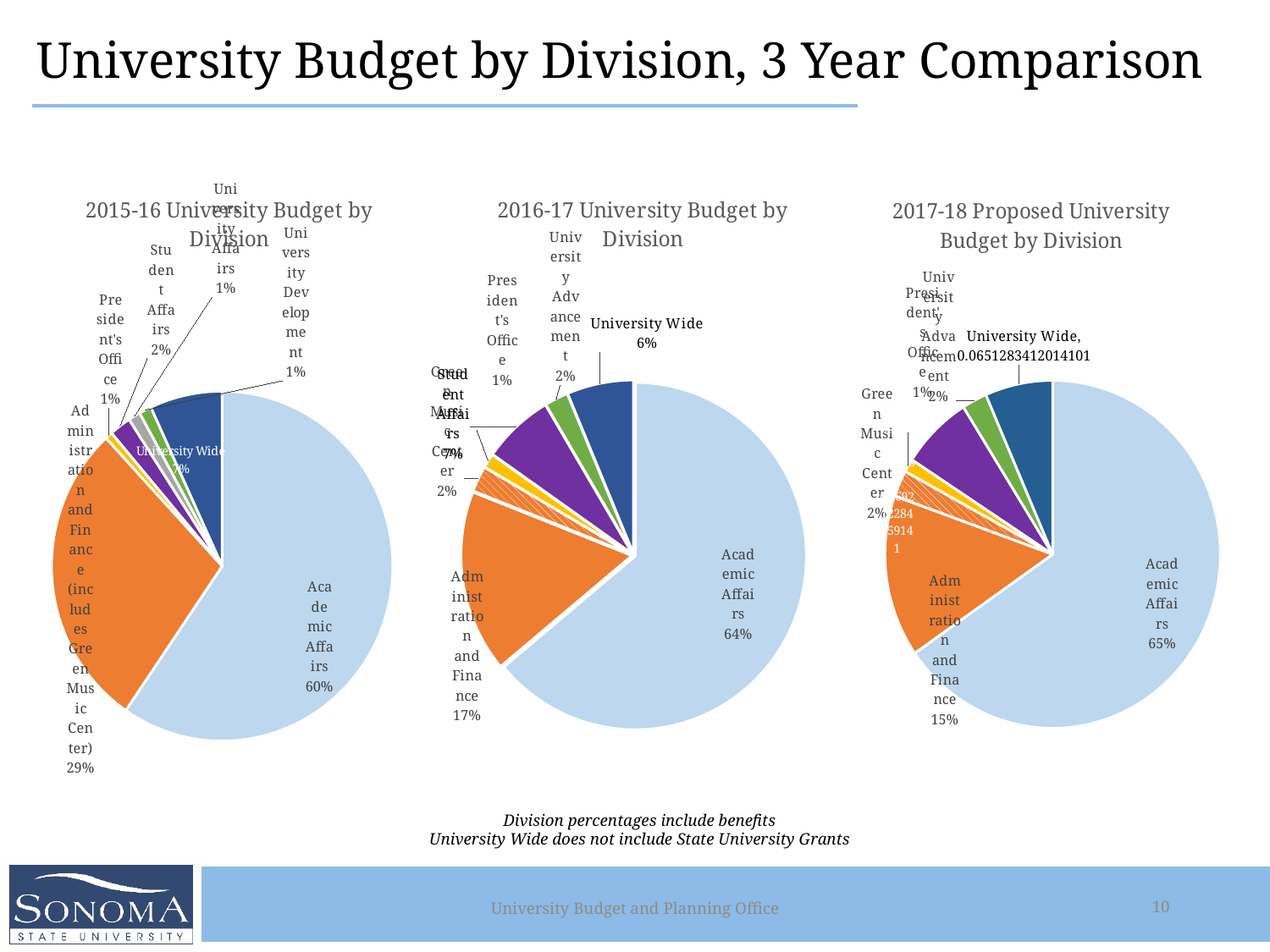
In the 2016-17 University Budget by Division chart, what is the difference in percentage points between Academic Affairs and Administration and Finance? 47 percentage points Is the Administration and Finance share larger in the 2015-16 chart or the 2016-17 chart? 2015-16 How many pie charts are on the slide? 3 Across the three charts from 2015-16 to 2017-18, does the Academic Affairs share rise or fall? Rise In the 2016-17 University Budget by Division chart, what percentage is University Wide? 6% In the 2015-16 University Budget by Division chart, which division has the largest share? Academic Affairs In the 2015-16 University Budget by Division chart, what percentage is Academic Affairs? 60% What kind of charts are shown on the slide? Pie charts In the 2017-18 Proposed University Budget by Division chart, what percentage is Academic Affairs? 65% In the 2017-18 Proposed University Budget by Division chart, what percentage is Administration and Finance? 15% In the 2016-17 University Budget by Division chart, what percentage is Administration and Finance? 17% In the 2016-17 University Budget by Division chart, what percentage is Academic Affairs? 64%